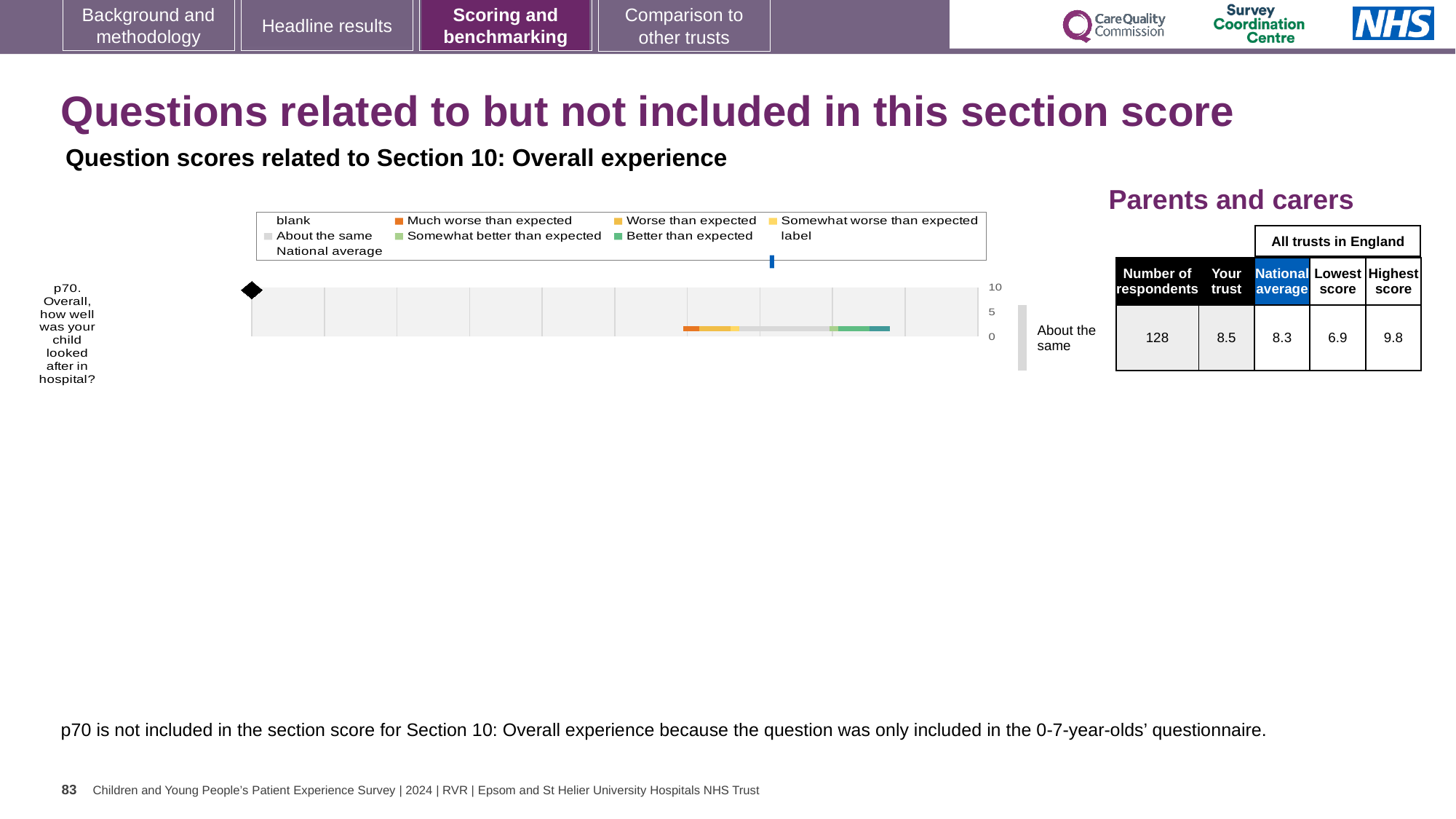
What is the lowest score among all trusts in England for p70? 6.9 How many respondents answered p70? 128 What is the national average score for p70? 8.3 Which legend entry is shown in orange? Much worse than expected How many survey questions are plotted in the chart? 1 What is the 'Your trust' score for p70 in the Parents and carers table? 8.5 Which is higher for p70, the 'Your trust' score or the national average? Your trust Is the 'Your trust' score for p70 greater or less than 5 on the chart axis? greater What is the difference between the highest and lowest trust scores for p70? 2.9 What kind of chart is used to show the p70 question score? bar chart What comparison label is shown to the right of the p70 bar? About the same What is the highest score among all trusts in England for p70? 9.8